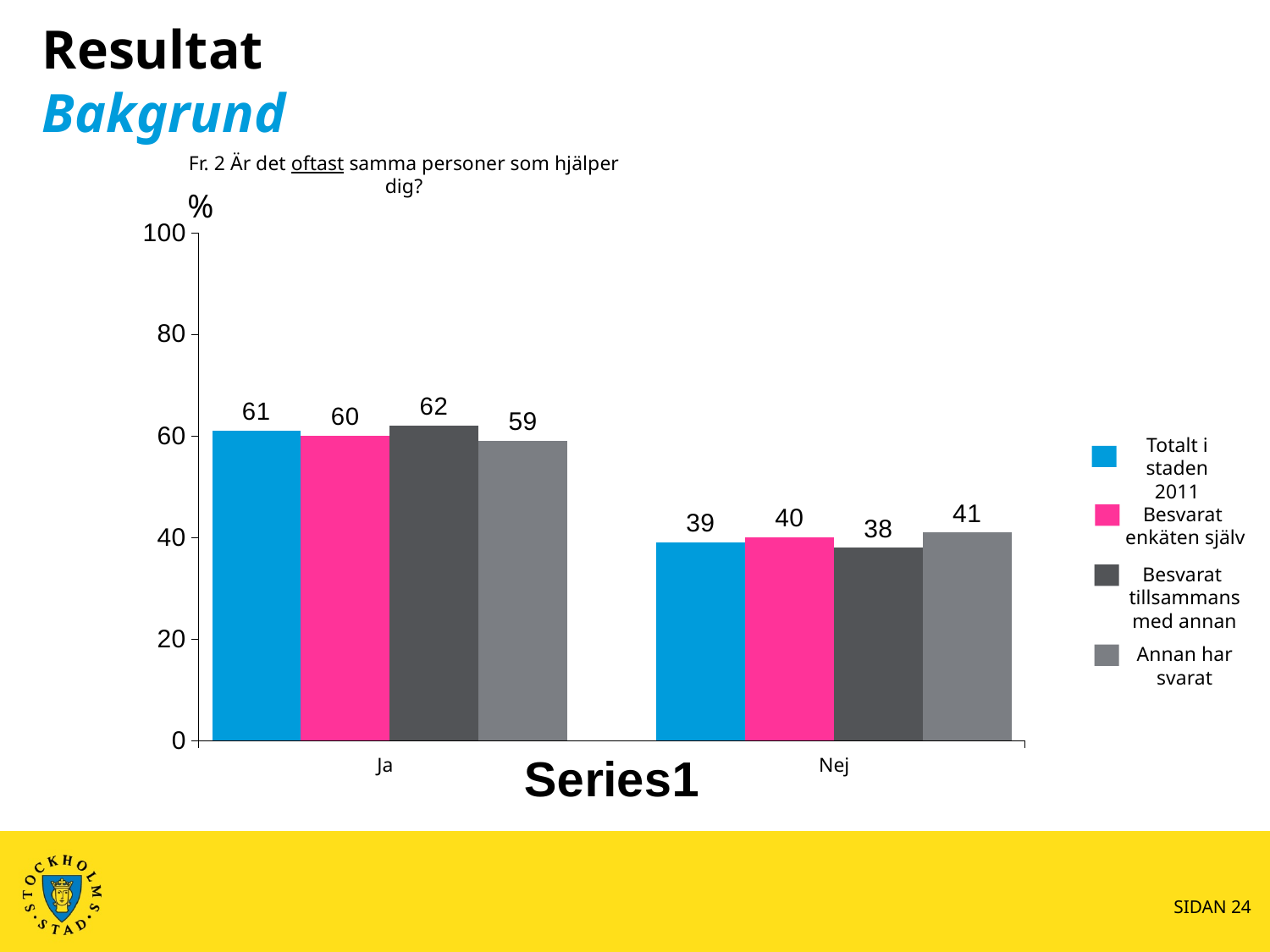
Which series has the lowest value in the "Nej" category? Besvarat tillsammans med annan What kind of chart is shown on the slide? Bar chart Which series has the highest value in the "Ja" category? Besvarat tillsammans med annan How many series does the legend list? 4 What is the difference between the "Ja" and "Nej" values for "Totalt i staden 2011"? 22 How many categories are shown on the x axis? 2 Which is larger: the "Ja" value for "Annan har svarat" or the "Ja" value for "Besvarat tillsammans med annan"? Besvarat tillsammans med annan What is the value for "Besvarat enkäten själv" in the "Nej" category? 40 What is the value for "Totalt i staden 2011" in the "Ja" category? 61 What is the value for "Besvarat tillsammans med annan" in the "Ja" category? 62 What is the value for "Annan har svarat" in the "Nej" category? 41 What is the question text shown as the chart title? Fr. 2 Är det oftast samma personer som hjälper dig?